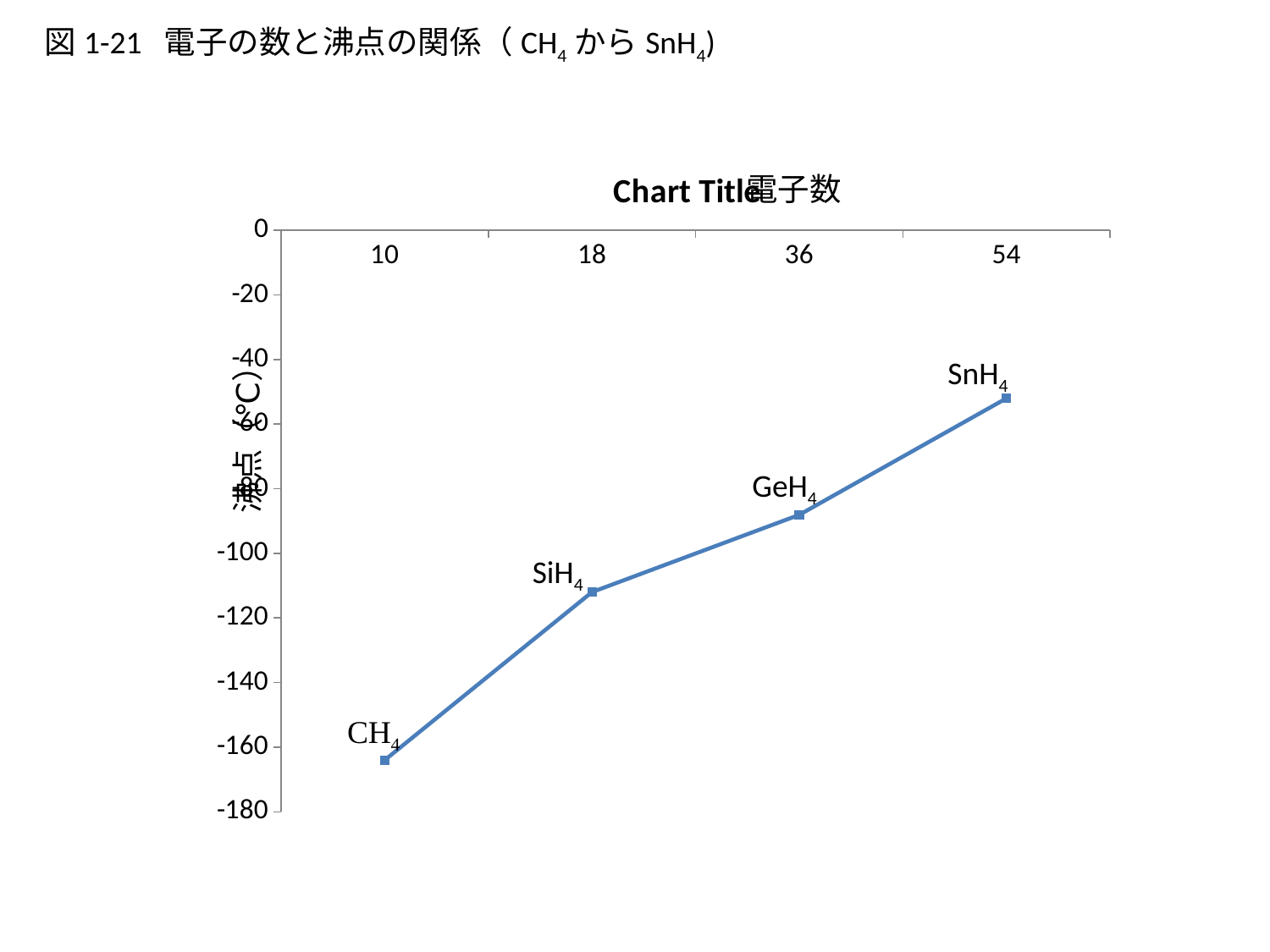
How many data points are plotted on the line? 4 Is the boiling point for SnH4 greater or less than -60? greater Which compound has the lowest boiling point on the chart? CH4 Which compound has the highest boiling point on the chart? SnH4 Is the boiling point for GeH4 greater or less than -100? greater Is the boiling point for SiH4 greater or less than -100? less What kind of chart is shown on the slide? line chart Which has the higher boiling point, SiH4 or GeH4? GeH4 What is the x-axis value (number of electrons) at which GeH4 is plotted? 36 Do the boiling points rise or fall as the number of electrons increases along the x axis? rise